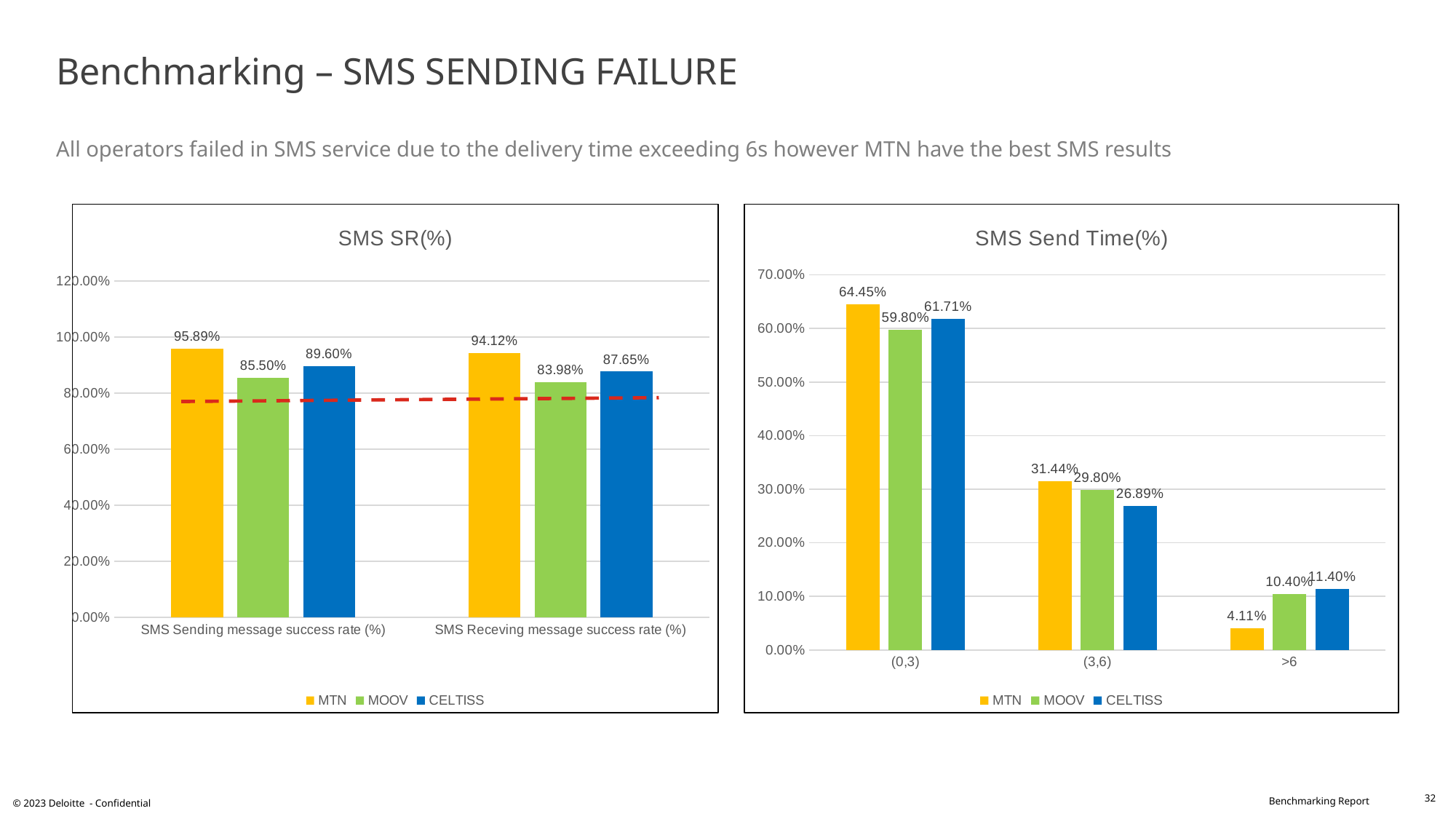
What kind of chart is the SMS Send Time(%) chart? Bar chart In the SMS SR(%) chart, what is the value for CELTISS for SMS Receving message success rate (%)? 87.65% In the SMS Send Time(%) chart, what is the difference between CELTISS and MTN in the >6 category? 7.29% In the SMS Send Time(%) chart, what is the value for MTN in the >6 category? 4.11% In the SMS Send Time(%) chart, which operator has the highest value in the (0,3) category? MTN In the SMS SR(%) chart, how many series does the legend list? 3 In the SMS Send Time(%) chart, what is the value for MOOV in the (0,3) category? 59.80% In the SMS Send Time(%) chart, how many categories are shown on the x axis? 3 In the SMS SR(%) chart, which operator has the lowest SMS Sending message success rate (%)? MOOV In the SMS SR(%) chart, what is the difference between MTN and MOOV for SMS Receving message success rate (%)? 10.14% In the SMS Send Time(%) chart, which is larger in the (3,6) category: MOOV or CELTISS? MOOV In the SMS SR(%) chart, what is the value for MTN for SMS Sending message success rate (%)? 95.89%